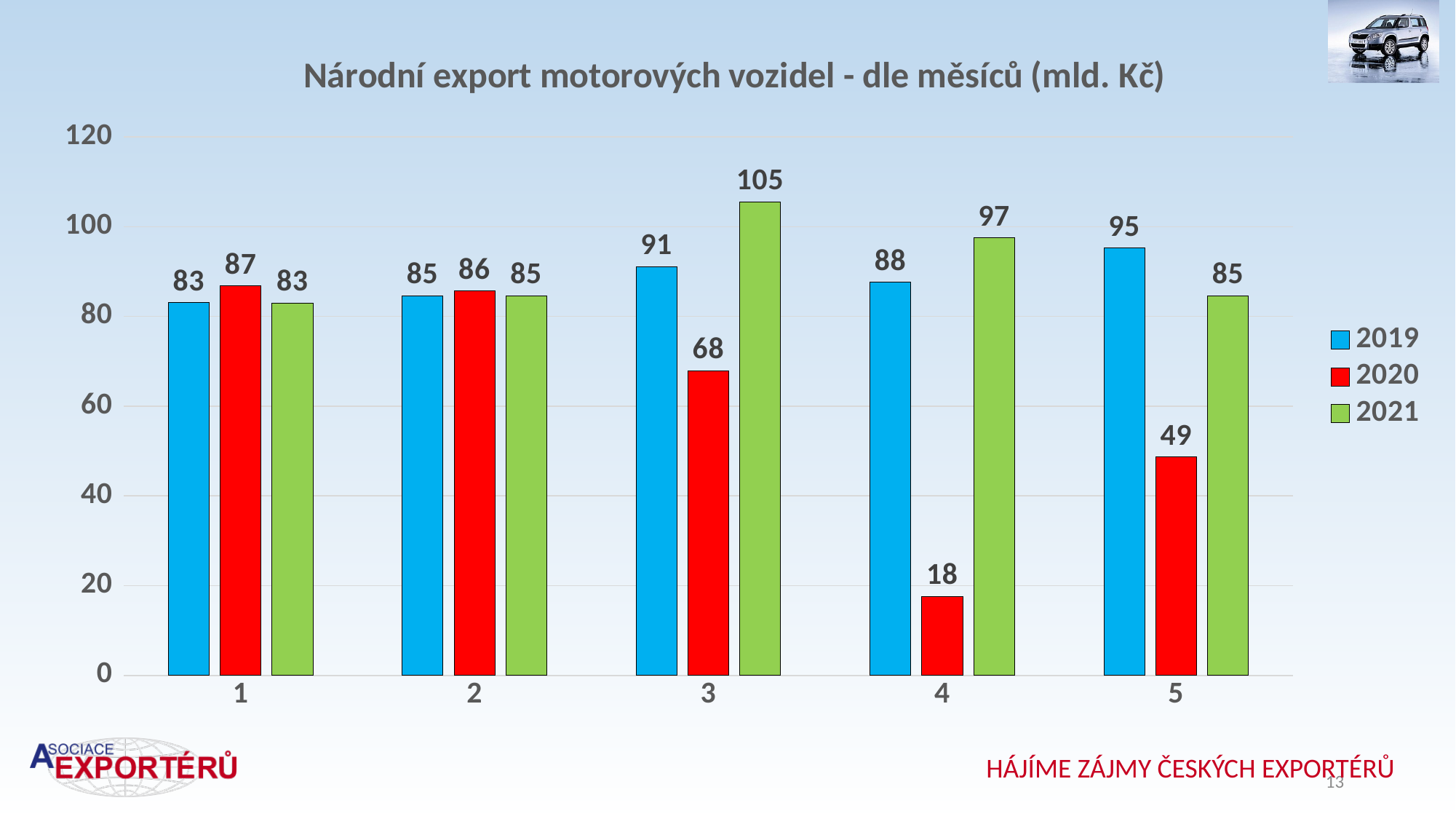
How many months are shown on the x axis? 5 What is the difference between the 2021 and 2020 values in month 5? 36 In month 3, which series has the larger value, 2019 or 2020? 2019 What is the value for 2020 in month 4? 18 Is the value for 2020 in month 4 greater or less than 20? less What is the title of the chart? Národní export motorových vozidel - dle měsíců (mld. Kč) Which month has the highest value for the 2021 series? 3 What is the value for 2021 in month 3? 105 What kind of chart is shown on the slide? bar chart Which month has the lowest value for the 2020 series? 4 How many series does the legend list? 3 What is the value for 2019 in month 5? 95